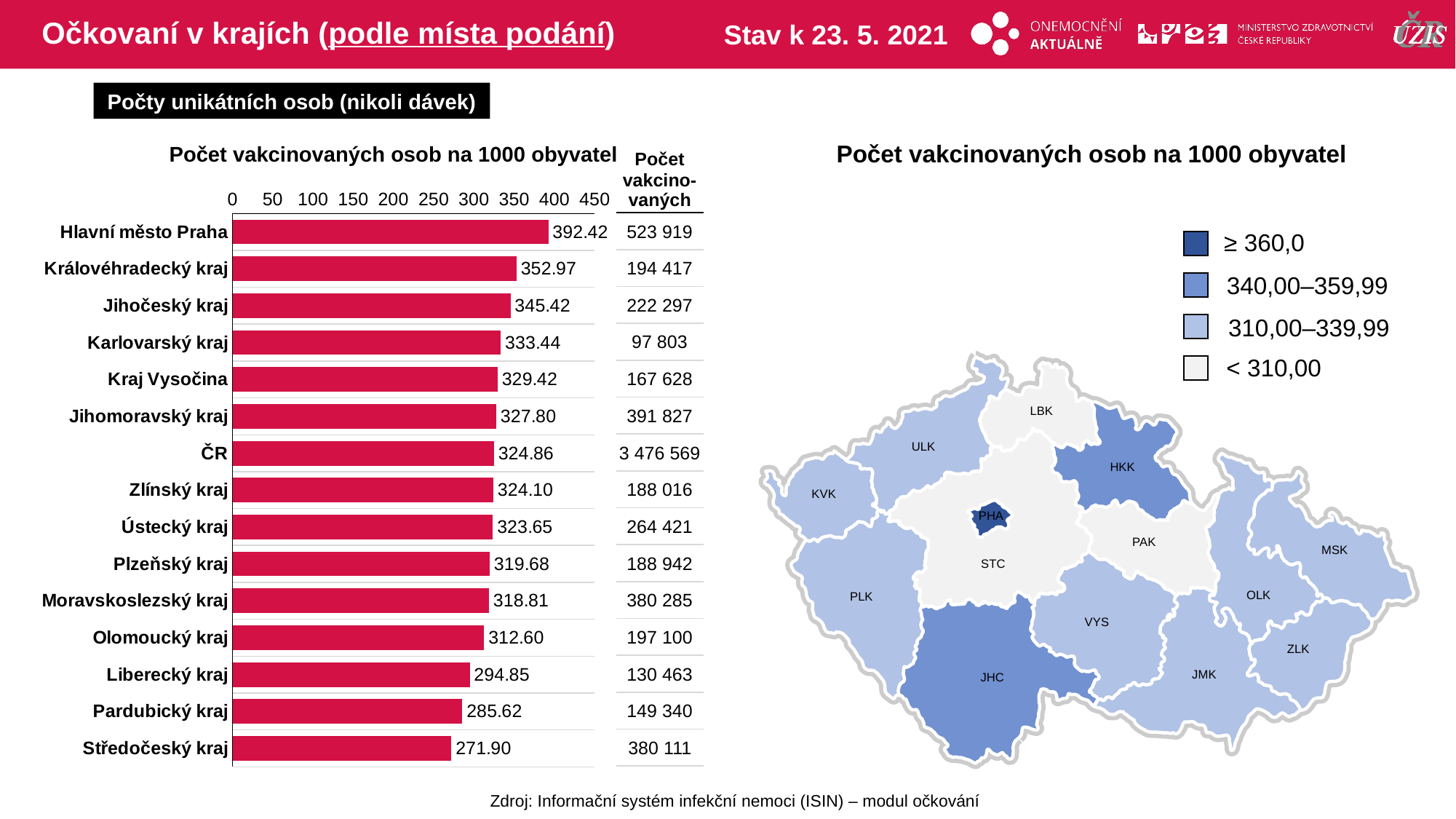
In the bar chart, what is the value for Jihomoravský kraj? 327.80 How many bars are shown in the bar chart? 15 In the bar chart, what is the difference between the values for Hlavní město Praha and Středočeský kraj? 120.52 In the bar chart, what is the value for ČR? 324.86 In the bar chart, which region has the lowest number of vaccinated persons per 1000 inhabitants? Středočeský kraj How many categories does the legend of the map on the right list? 4 What is the title of the bar chart? Počet vakcinovaných osob na 1000 obyvatel What kind of chart is shown on the left of the slide? bar chart In the bar chart, what is the value for Hlavní město Praha? 392.42 In the bar chart, which has a larger value: Královéhradecký kraj or Liberecký kraj? Královéhradecký kraj In the bar chart, is the value for Pardubický kraj greater or less than 300? less In the bar chart, which region has the highest number of vaccinated persons per 1000 inhabitants? Hlavní město Praha